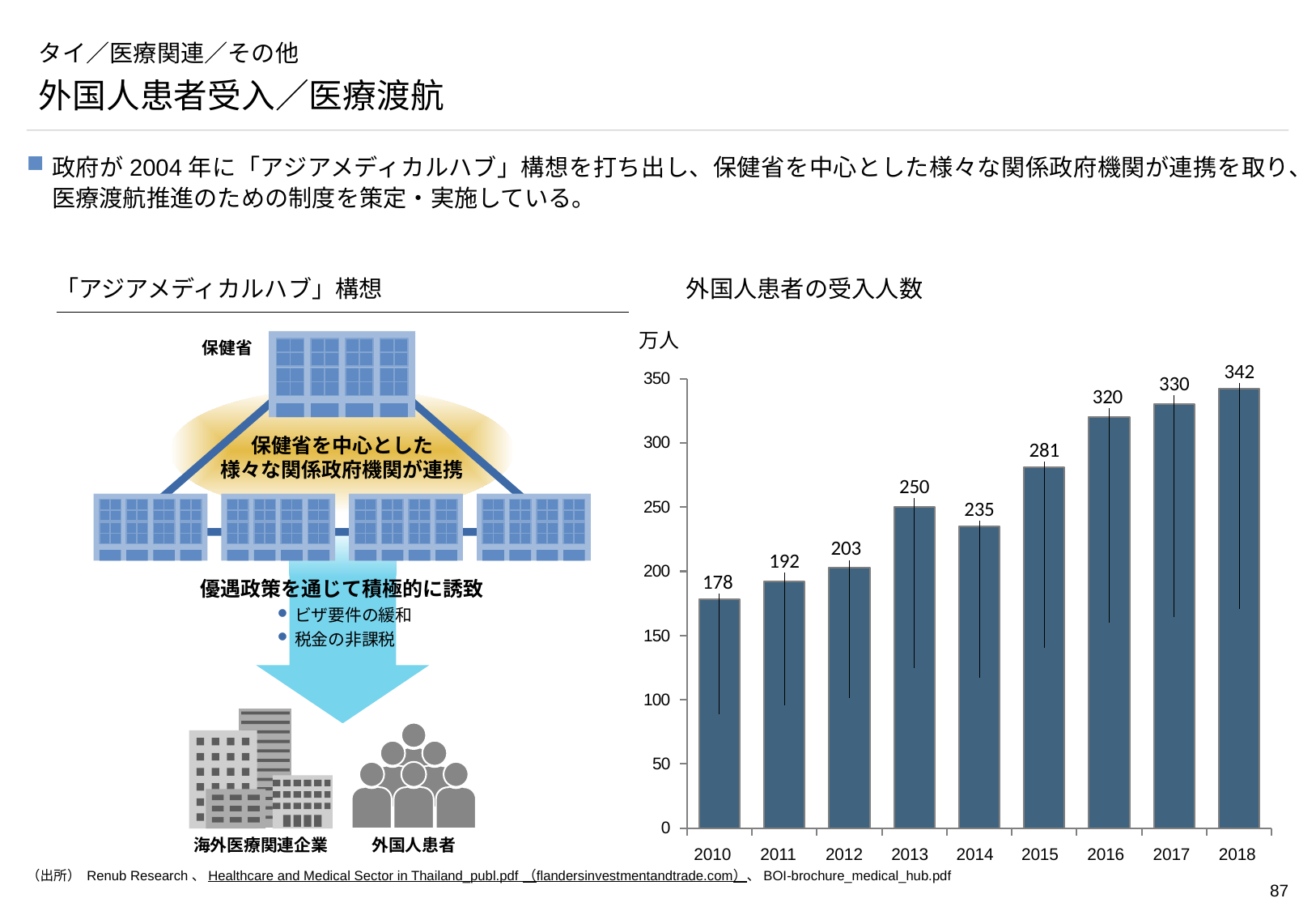
What is the difference between the values for 2018 and 2010 in the 外国人患者の受入人数 chart? 164 Which year has the highest value in the 外国人患者の受入人数 chart? 2018 What is the value for 2018 in the 外国人患者の受入人数 chart? 342 Which is larger in the 外国人患者の受入人数 chart, the value for 2013 or the value for 2014? 2013 How many years are shown in the 外国人患者の受入人数 chart? 9 Which year has the lowest value in the 外国人患者の受入人数 chart? 2010 Is the value for 2015 in the 外国人患者の受入人数 chart greater or less than 300? less What is the difference between the values for 2013 and 2014 in the 外国人患者の受入人数 chart? 15 What unit is shown on the axis of the 外国人患者の受入人数 chart? 万人 What is the value for 2014 in the 外国人患者の受入人数 chart? 235 What is the value for 2010 in the 外国人患者の受入人数 chart? 178 What kind of chart is the 外国人患者の受入人数 chart? bar chart